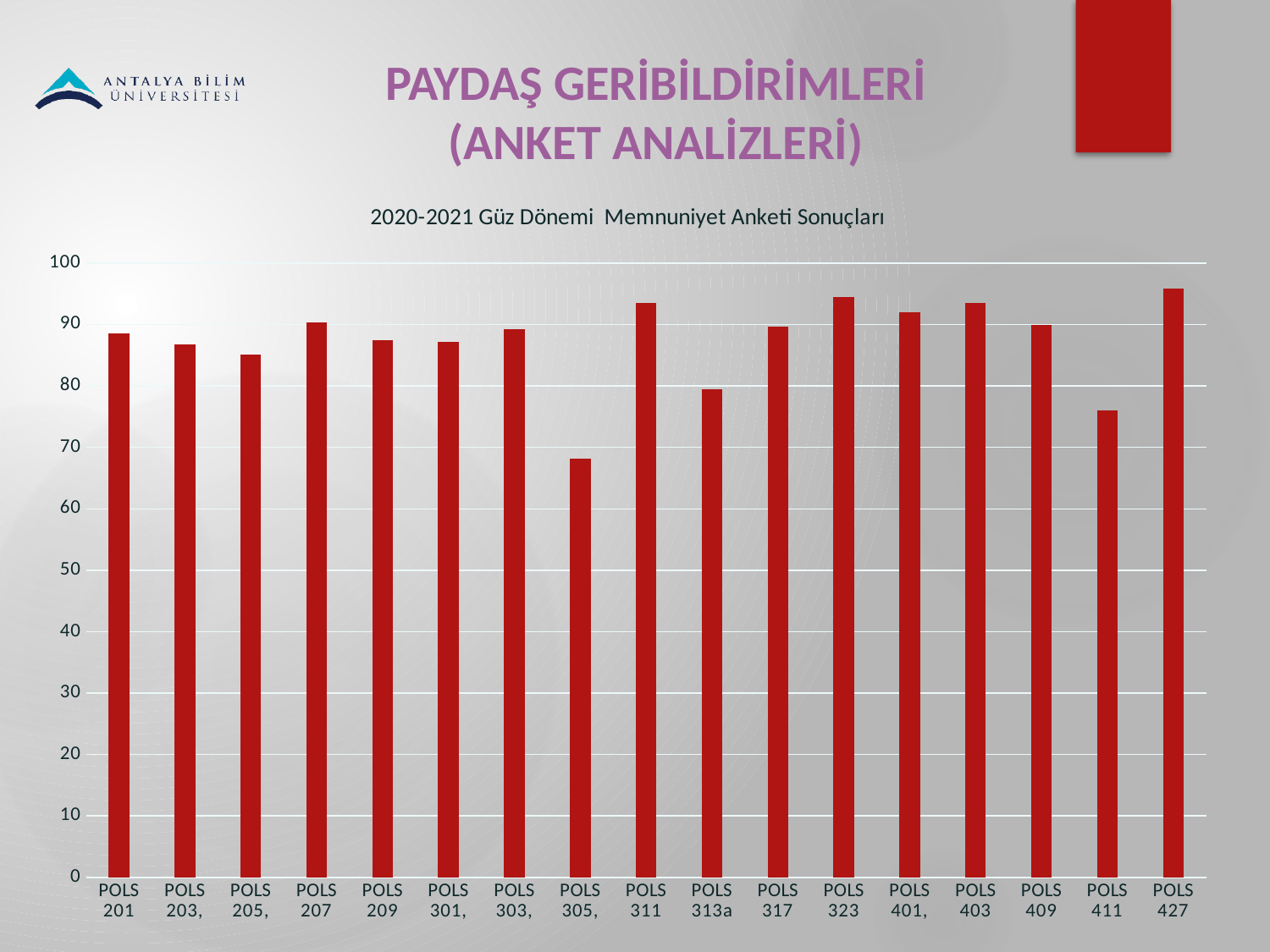
How many courses (bars) are shown in the chart? 17 Which has the larger value, POLS 305 or POLS 311? POLS 311 Which course has the lowest value in the chart? POLS 305 Which course has the highest value in the chart? POLS 427 What is the title of the chart? 2020-2021 Güz Dönemi Memnuniyet Anketi Sonuçları Is the value for POLS 411 greater or less than 80? less Which has the larger value, POLS 411 or POLS 201? POLS 201 Is the value for POLS 205 greater or less than 80? greater Is the value for POLS 305 greater or less than 70? less What kind of chart is shown on the slide? bar chart